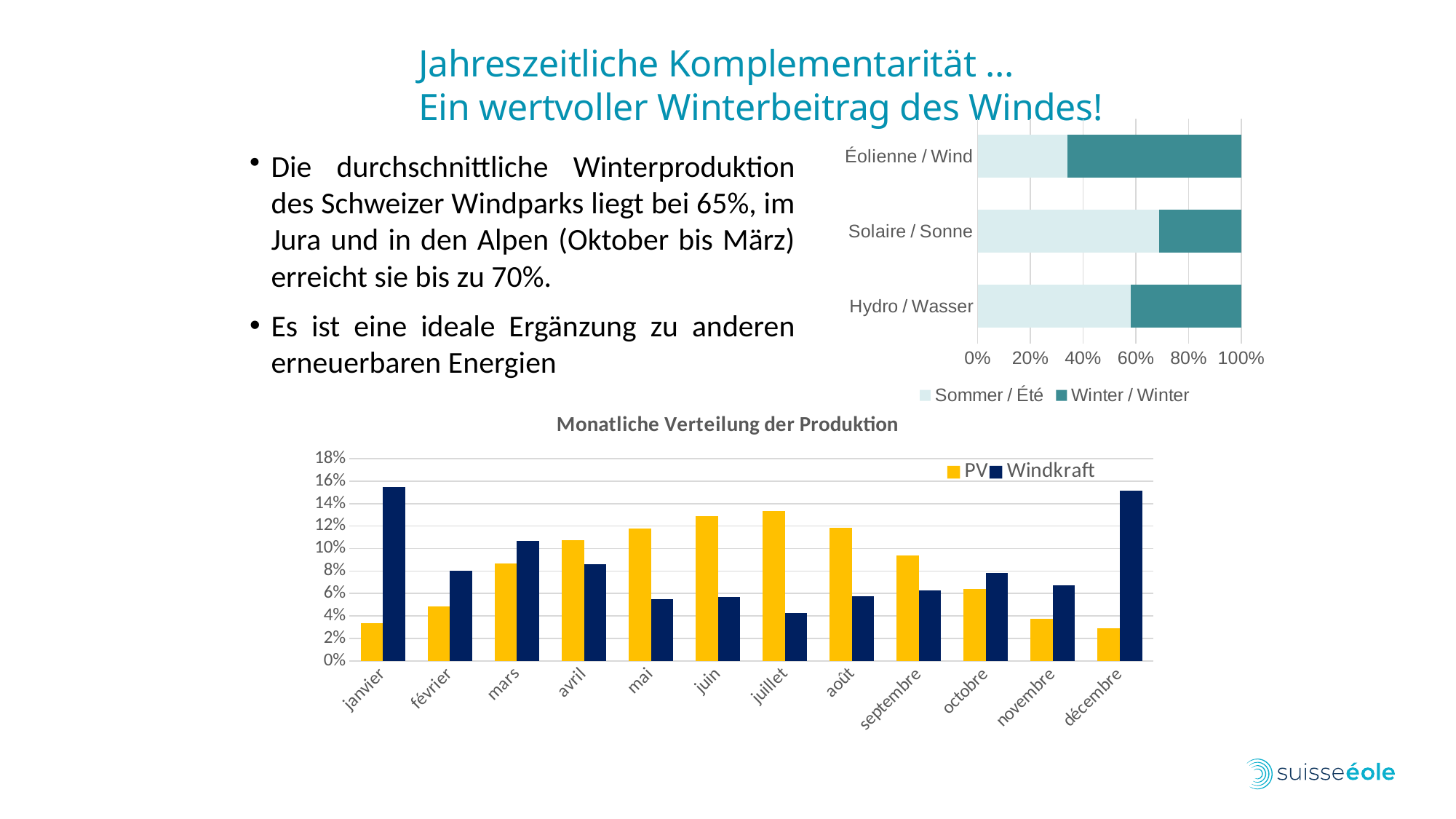
In the chart 'Monatliche Verteilung der Produktion', in which month is the Windkraft value lowest? juillet In the chart 'Monatliche Verteilung der Produktion', which is larger in janvier, PV or Windkraft? Windkraft In the top-right chart, is the Sommer / Été share for Hydro / Wasser greater or less than 40%? greater In the chart 'Monatliche Verteilung der Produktion', is the Windkraft value for janvier greater or less than 14%? greater In the chart 'Monatliche Verteilung der Produktion', which series does the legend list besides PV? Windkraft In the top-right chart, how many series does the legend list? 2 In the top-right chart, which category has the largest Winter / Winter share? Éolienne / Wind In the chart 'Monatliche Verteilung der Produktion', how many months are shown on the x axis? 12 What kind of chart is the top-right chart with Éolienne / Wind, Solaire / Sonne and Hydro / Wasser? Stacked bar chart In the top-right chart, is the Sommer / Été share for Éolienne / Wind greater or less than 40%? less In the top-right chart, which category has the smallest Winter / Winter share? Solaire / Sonne In the chart 'Monatliche Verteilung der Produktion', does the PV value rise or fall from janvier to juillet? rise